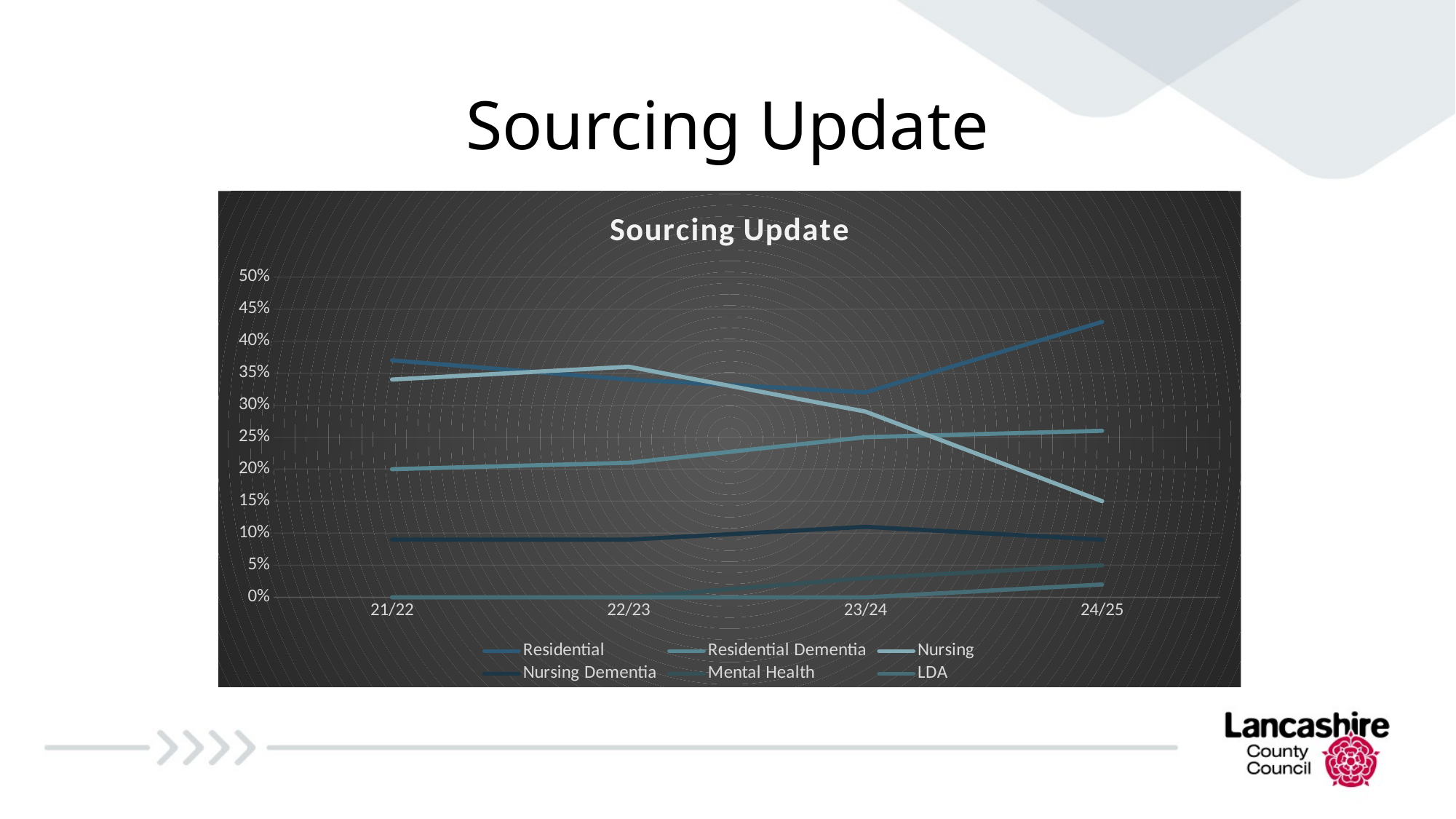
What kind of chart is shown on the slide? Line chart Is the value for Residential Dementia in 21/22 greater or less than 25%? less How many time periods are shown on the x axis? 4 Is the value for Residential in 24/25 greater or less than 40%? greater How many series does the legend list? 6 Does the Nursing line rise or fall between 22/23 and 24/25? Fall Which series has the highest value in 24/25? Residential In 24/25, which is larger: Residential or Nursing? Residential What is the title of the chart? Sourcing Update Is the value for Nursing Dementia in 23/24 greater or less than 5%? greater Which series is listed last in the legend? LDA